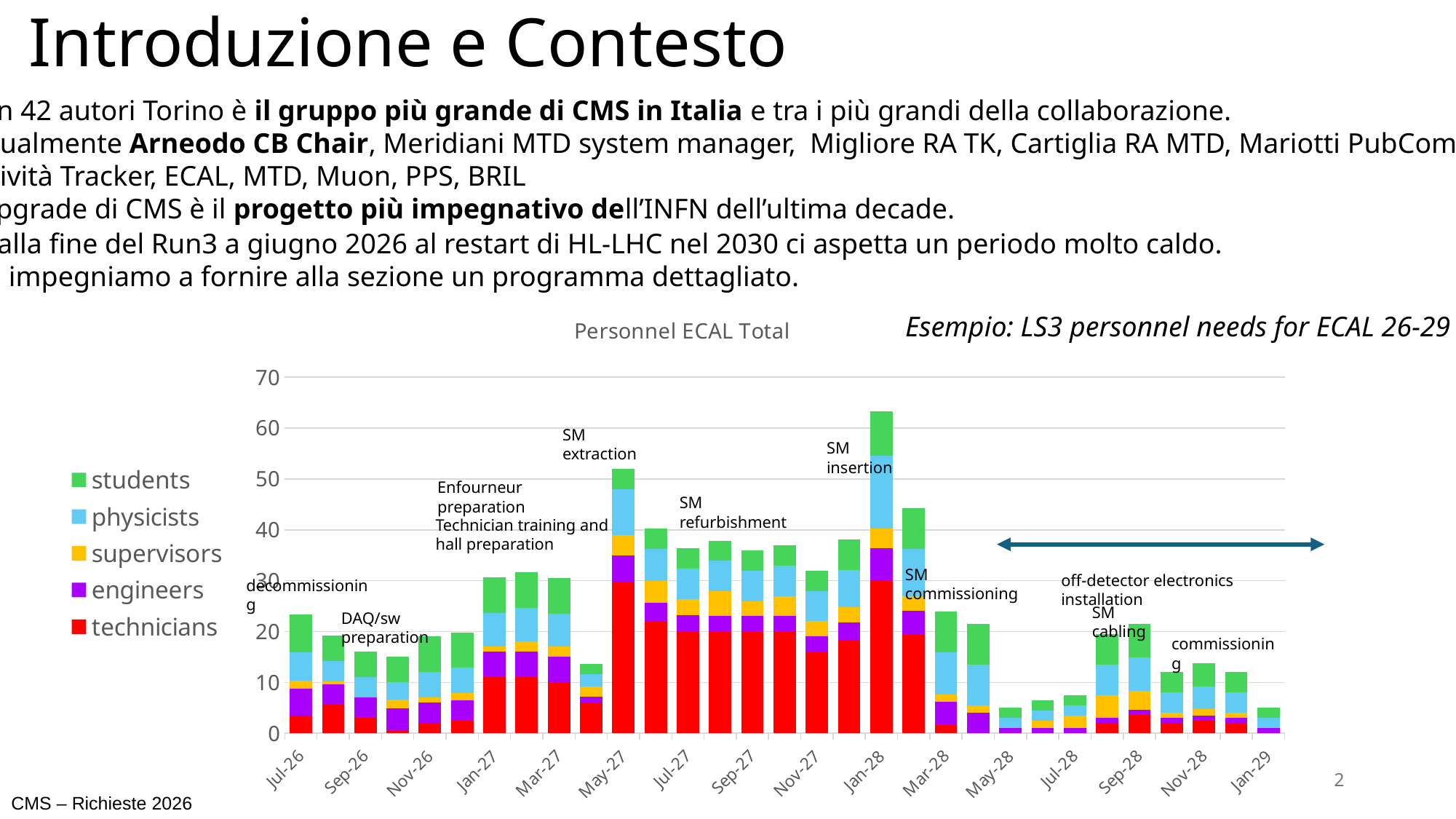
What kind of chart is shown on the slide? Stacked bar chart Which has a larger total personnel, Jul-26 or Sep-26? Jul-26 Do the total personnel values rise or fall from Jan-28 to May-28? Fall Which has a larger total personnel, Jan-28 or May-27? Jan-28 Is the technicians value for May-27 greater or less than 20? greater Which month has the highest total personnel in the chart? Jan-28 Is the total personnel for Jul-28 greater or less than 10? less What is the title of the chart? Personnel ECAL Total Is the total personnel for Jan-28 greater or less than 60? greater How many series does the legend of the chart list? 5 Which colour represents technicians in the chart? Red